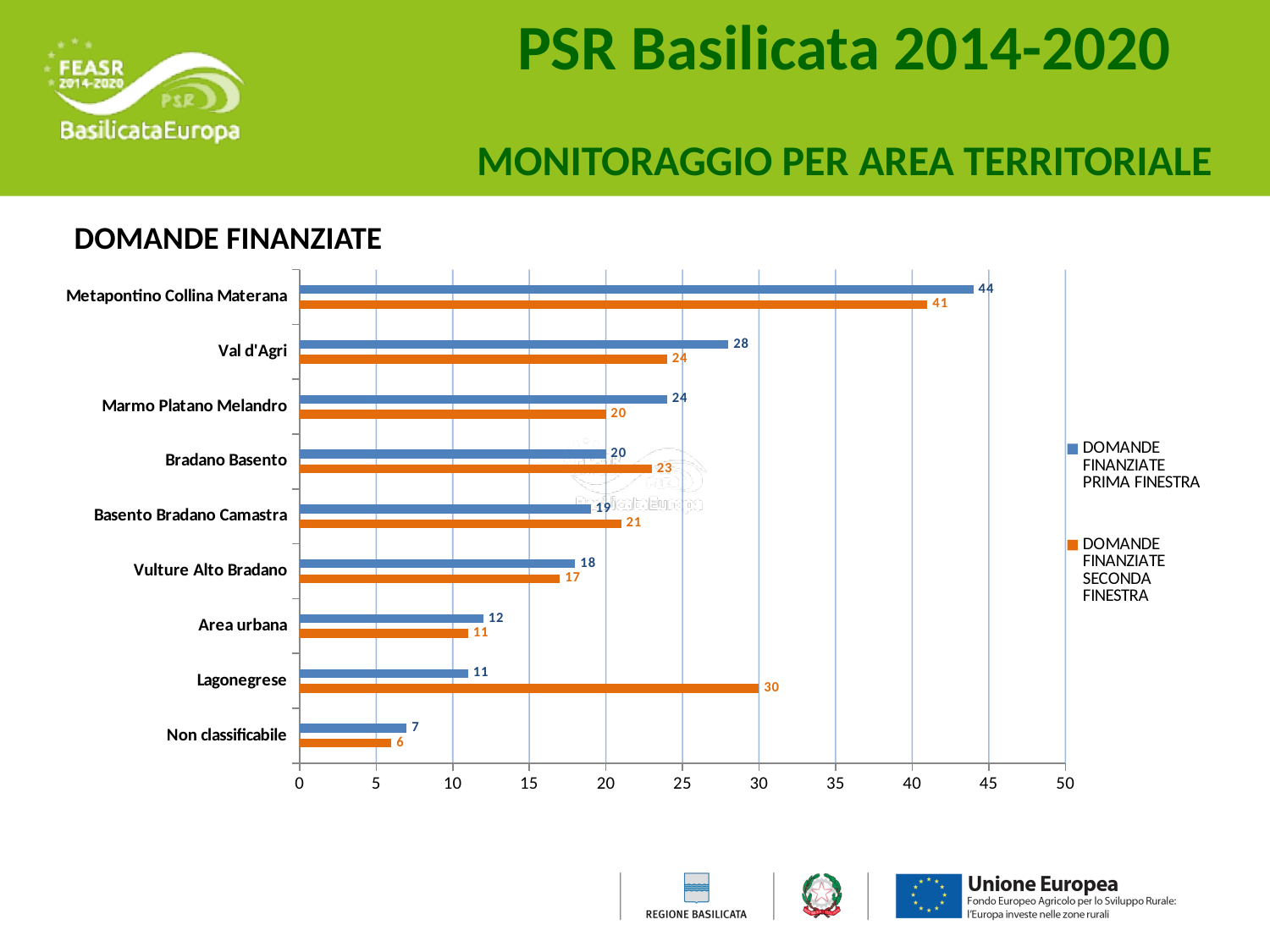
What is the value of DOMANDE FINANZIATE PRIMA FINESTRA for Metapontino Collina Materana? 44 Which area has the highest value for DOMANDE FINANZIATE SECONDA FINESTRA? Metapontino Collina Materana What is the title of the chart? DOMANDE FINANZIATE Is the PRIMA FINESTRA value for Val d'Agri greater or less than 25? greater Which area has the lowest value for DOMANDE FINANZIATE PRIMA FINESTRA? Non classificabile How many series does the legend list? 2 How many territorial areas are shown on the chart? 9 For Bradano Basento, which is larger: the PRIMA FINESTRA value or the SECONDA FINESTRA value? SECONDA FINESTRA What is the difference between the PRIMA FINESTRA and SECONDA FINESTRA values for Lagonegrese? 19 What is the value of DOMANDE FINANZIATE SECONDA FINESTRA for Lagonegrese? 30 What kind of chart is shown on the slide? Bar chart What colour represents DOMANDE FINANZIATE SECONDA FINESTRA? Orange